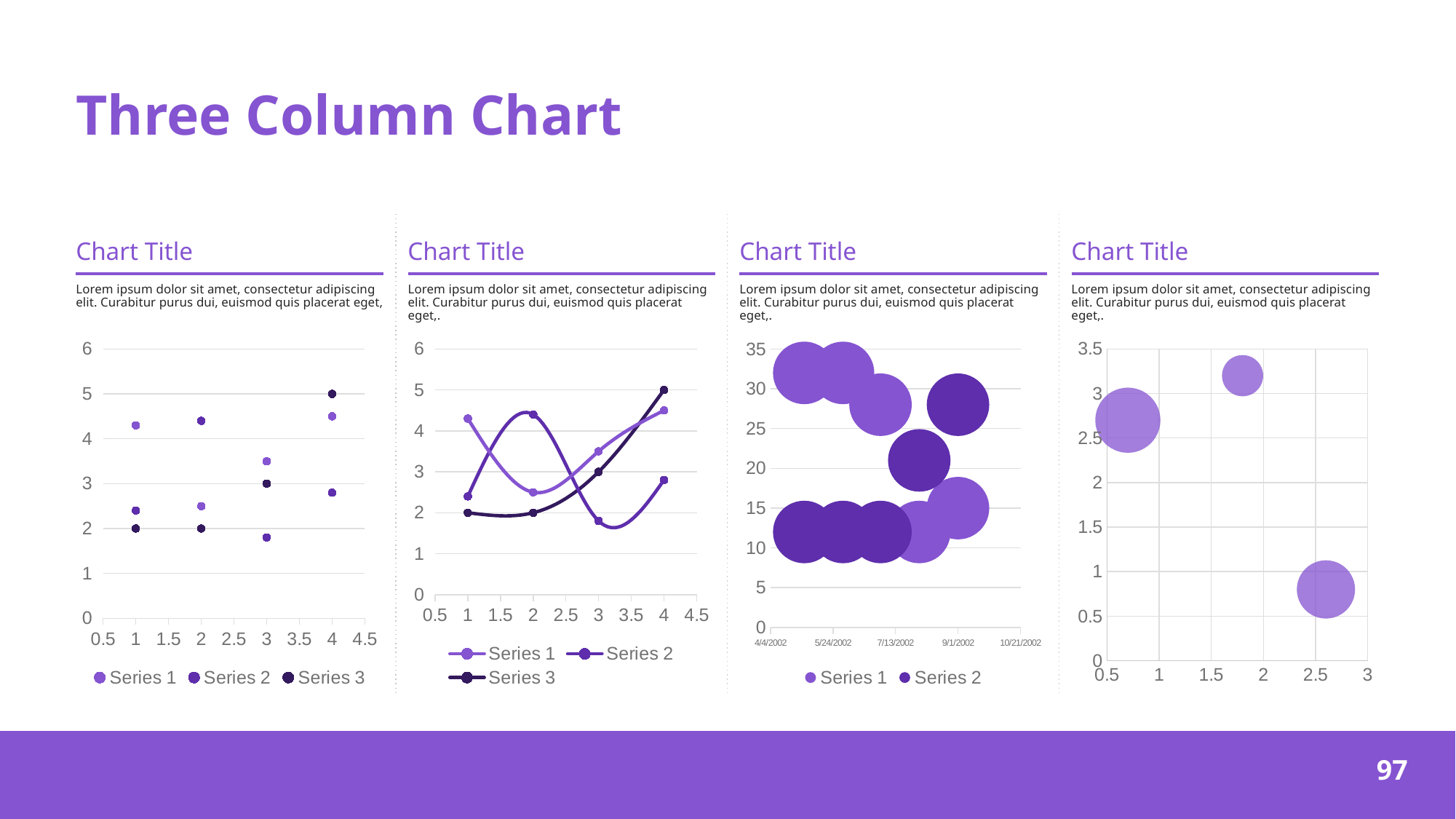
How many series does the legend of the third chart from the left list? 2 In the leftmost chart, what is the Series 3 value at x = 4? 5 How many series does the legend of the second chart from the left list? 3 What type of chart is the third chart from the left? bubble chart How many bubbles are plotted in the rightmost chart? 3 In the leftmost chart, is the Series 1 value at x = 1 greater or less than 4? greater In the second chart from the left, what is the Series 3 value at x = 4? 5 In the second chart from the left, is the Series 2 value at x = 3 greater or less than 2? less What type of chart is the second chart from the left? line chart How many series does the legend of the leftmost chart list? 3 In the second chart from the left, which series reaches the highest value? Series 3 What type of chart is the leftmost chart on the slide? scatter chart